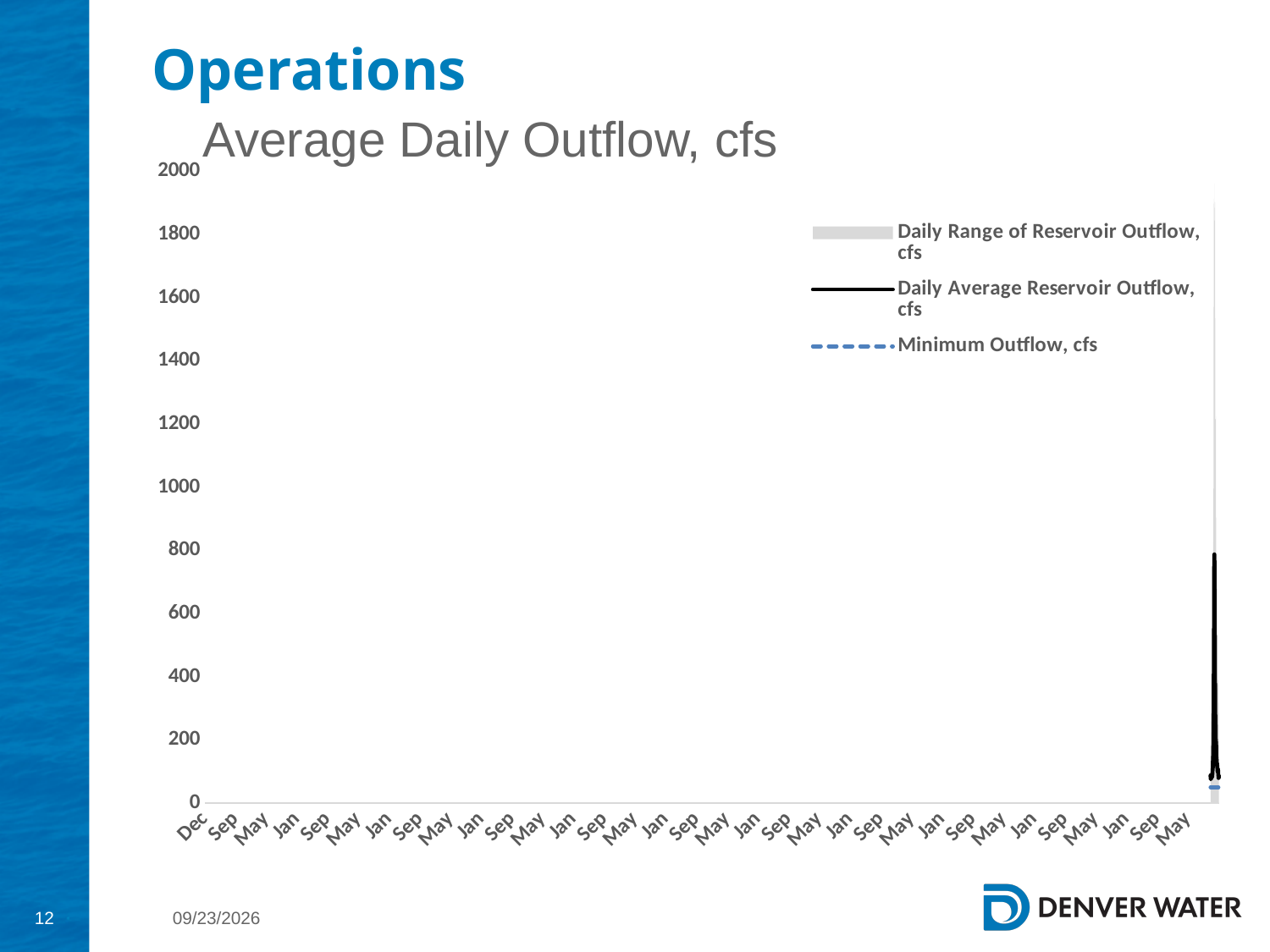
What is the title of the chart on the slide? Average Daily Outflow, cfs What is the first label on the chart's horizontal axis? Dec What kind of chart is shown on the slide? combination area and line chart What is the interval between consecutive tick labels on the vertical axis? 200 How many series does the chart's legend list? 3 Is the peak of the Daily Average Reservoir Outflow line at the far right of the chart greater or less than 1000? less Is the peak of the Daily Average Reservoir Outflow line at the far right of the chart greater or less than 400? greater